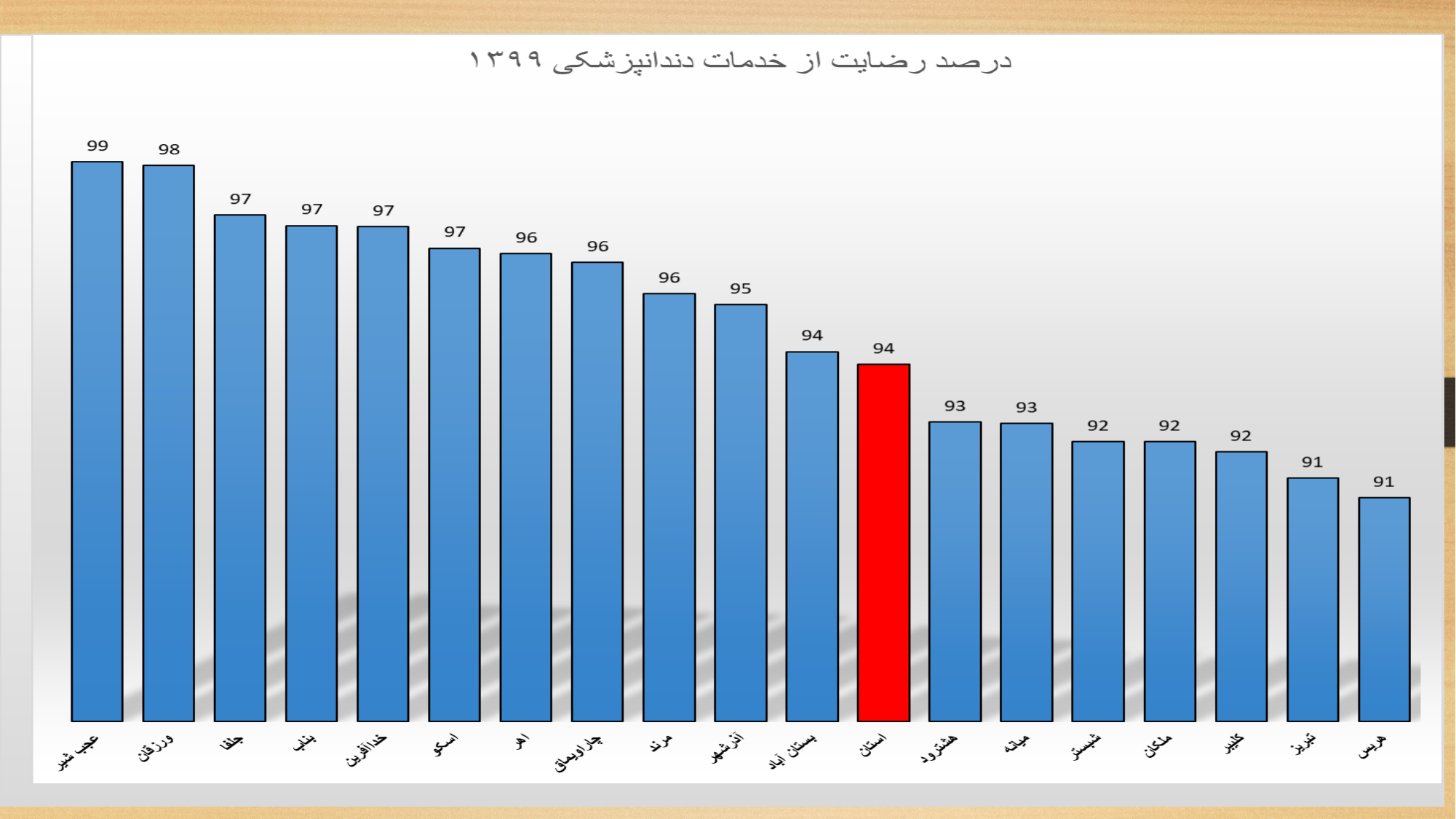
What is the difference between the values for عجب شیر and هریس? 8 How many bars are plotted in the chart? 19 What is the value for استان (the red bar)? 94 What is the value for عجب شیر? 99 What type of chart is shown on the slide? bar chart Which is larger, the value for مرند or the value for میانه? مرند Do the values rise or fall from left to right across the chart? fall What is the value for آذرشهر? 95 Which bar is coloured red instead of blue? استان What is the value for تبریز? 91 What is the difference between the values for ورزقان and استان? 4 Which category has the highest value? عجب شیر